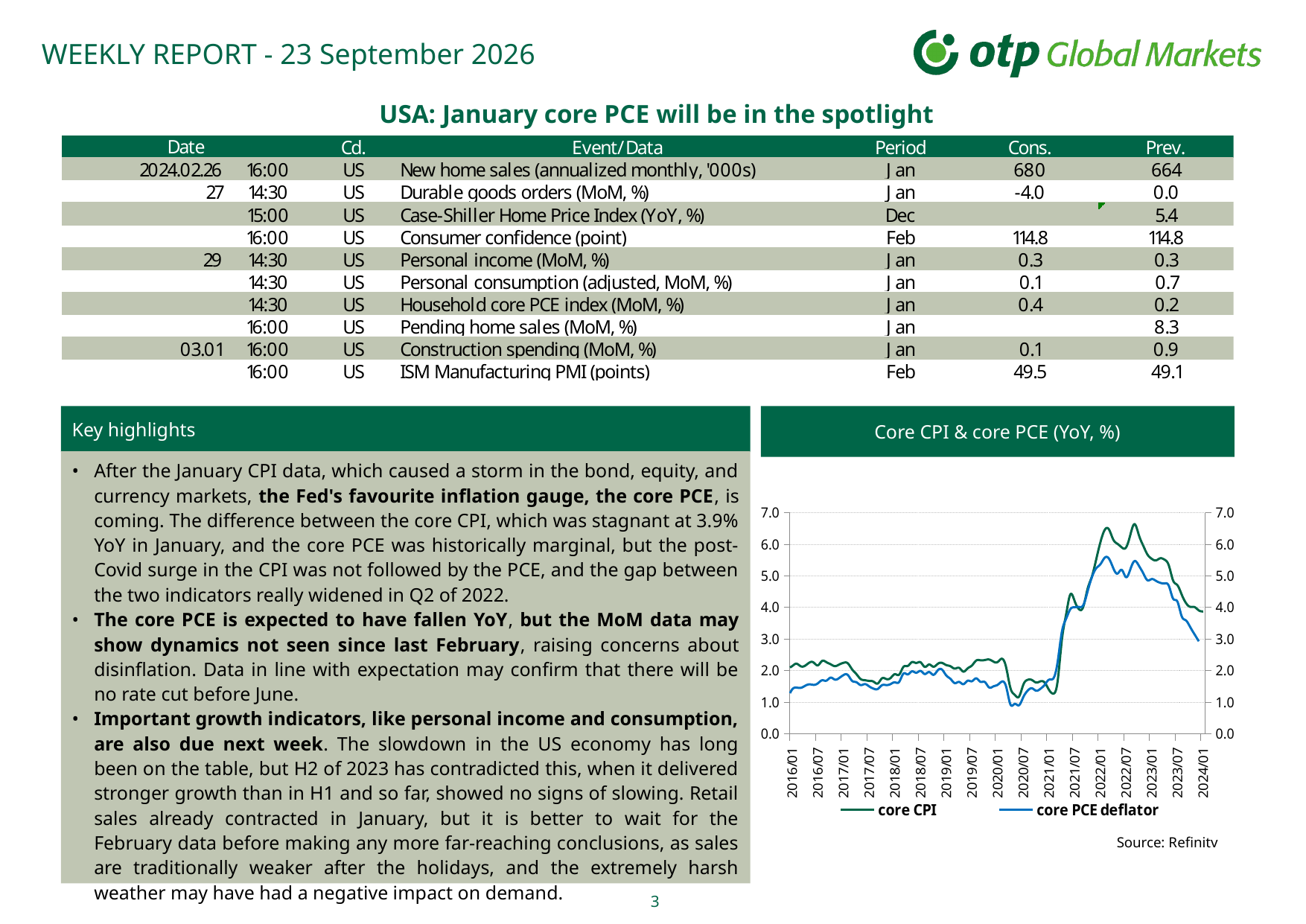
In the "Core CPI & core PCE (YoY, %)" chart, is the peak value of the core PCE deflator in 2022 greater or less than 6.0? less In the "Core CPI & core PCE (YoY, %)" chart, which series is drawn in blue? core PCE deflator What kind of chart is shown under the title "Core CPI & core PCE (YoY, %)"? line chart In the "Core CPI & core PCE (YoY, %)" chart, is the peak value of core CPI around 2022/07 greater or less than 6.0? greater In the "Core CPI & core PCE (YoY, %)" chart, is the core PCE deflator value at 2016/01 greater or less than 1.0? greater In the "Core CPI & core PCE (YoY, %)" chart, does the core PCE deflator rise or fall between 2022/07 and 2024/01? fall How many series does the legend of the "Core CPI & core PCE (YoY, %)" chart list? 2 In the "Core CPI & core PCE (YoY, %)" chart, does core CPI rise or fall between 2021/01 and 2022/07? rise In the "Core CPI & core PCE (YoY, %)" chart, which series reaches the higher peak, core CPI or core PCE deflator? core CPI What is the highest value shown on the vertical axis of the "Core CPI & core PCE (YoY, %)" chart? 7.0 In the "Core CPI & core PCE (YoY, %)" chart, which series is higher at 2024/01, core CPI or core PCE deflator? core CPI